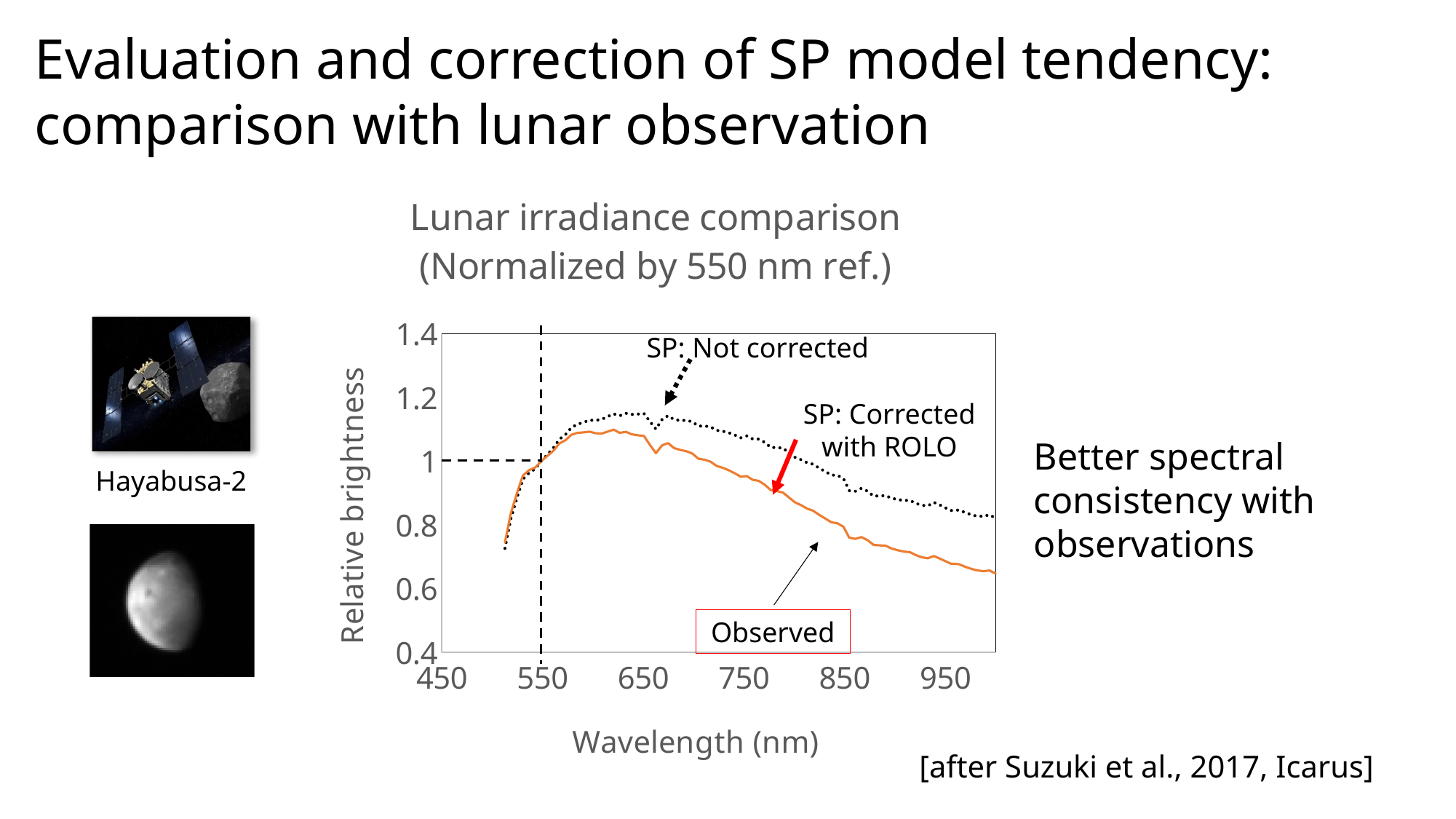
At 950 nm, which curve is higher: SP: Not corrected or Observed? SP: Not corrected What is the title of the chart? Lunar irradiance comparison (Normalized by 550 nm ref.) Is the value of the SP: Not corrected curve at 850 nm greater or less than 1? less What kind of chart is shown on the slide? Line chart What is the label of the x axis of the chart? Wavelength (nm) Do the curves rise or fall between 650 nm and 950 nm? Fall How many wavelength tick labels are shown on the x axis? 6 Is the value of the Observed curve at 950 nm greater or less than 0.8? less Is the value of the SP: Corrected with ROLO curve at 650 nm greater or less than 1? greater What is the relative brightness of the curves at 550 nm, where the dashed reference lines cross? 1 How many series are annotated on the chart? 3